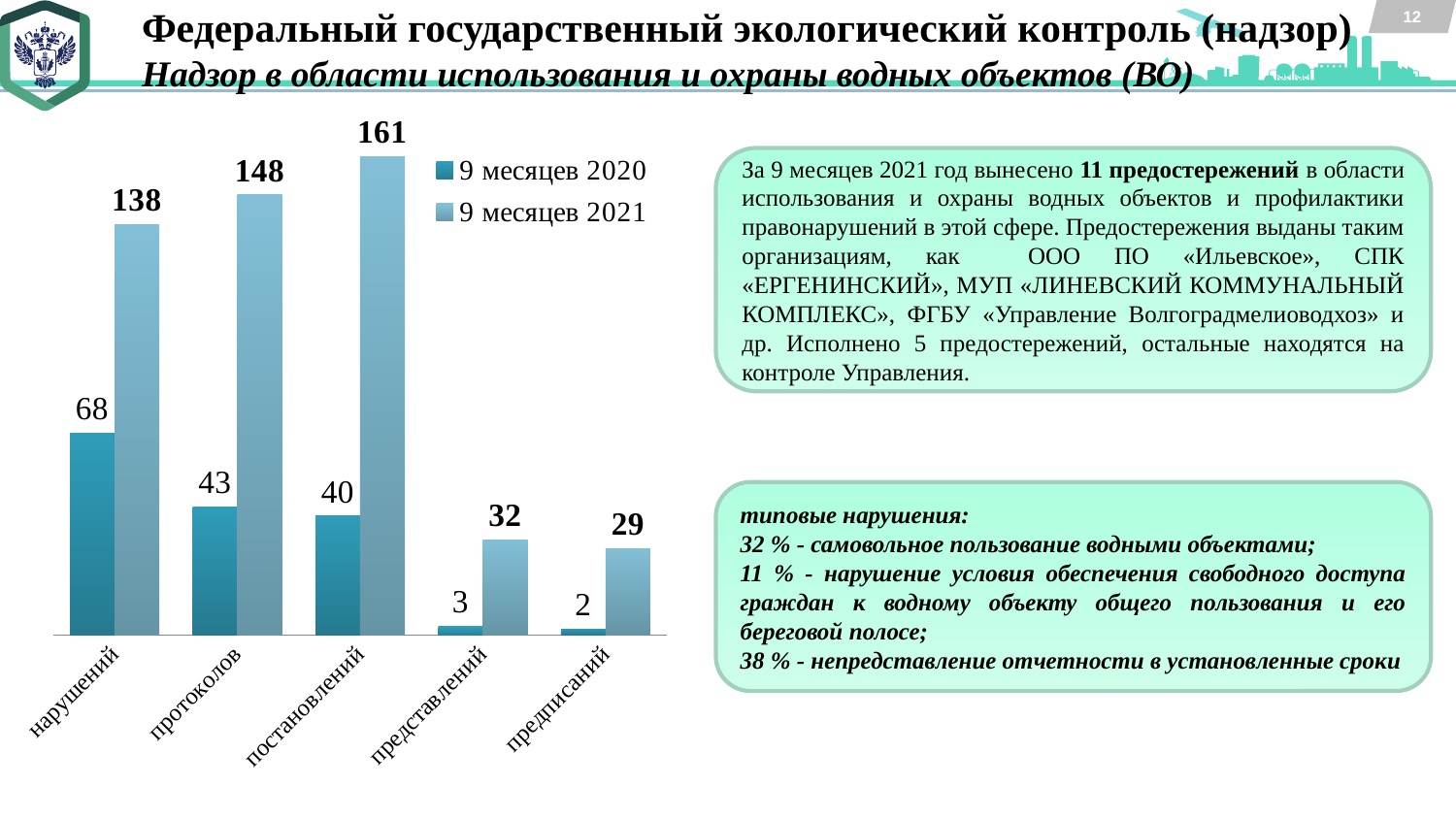
What is the value for "представлений" in the "9 месяцев 2020" series? 3 What kind of chart is shown on the slide? bar chart What is the value for "предписаний" in the "9 месяцев 2021" series? 29 What is the value for "нарушений" in the "9 месяцев 2020" series? 68 Which is larger: the "9 месяцев 2020" value for "нарушений" or the "9 месяцев 2020" value for "протоколов"? нарушений What are the two legend entries of the chart? 9 месяцев 2020 and 9 месяцев 2021 What is the difference between the "9 месяцев 2021" and "9 месяцев 2020" values for "протоколов"? 105 What is the value for "постановлений" in the "9 месяцев 2021" series? 161 How many series does the chart legend list? 2 Which category has the highest value in the "9 месяцев 2021" series? постановлений How many categories are shown on the x axis of the chart? 5 Which category has the lowest value in the "9 месяцев 2020" series? предписаний